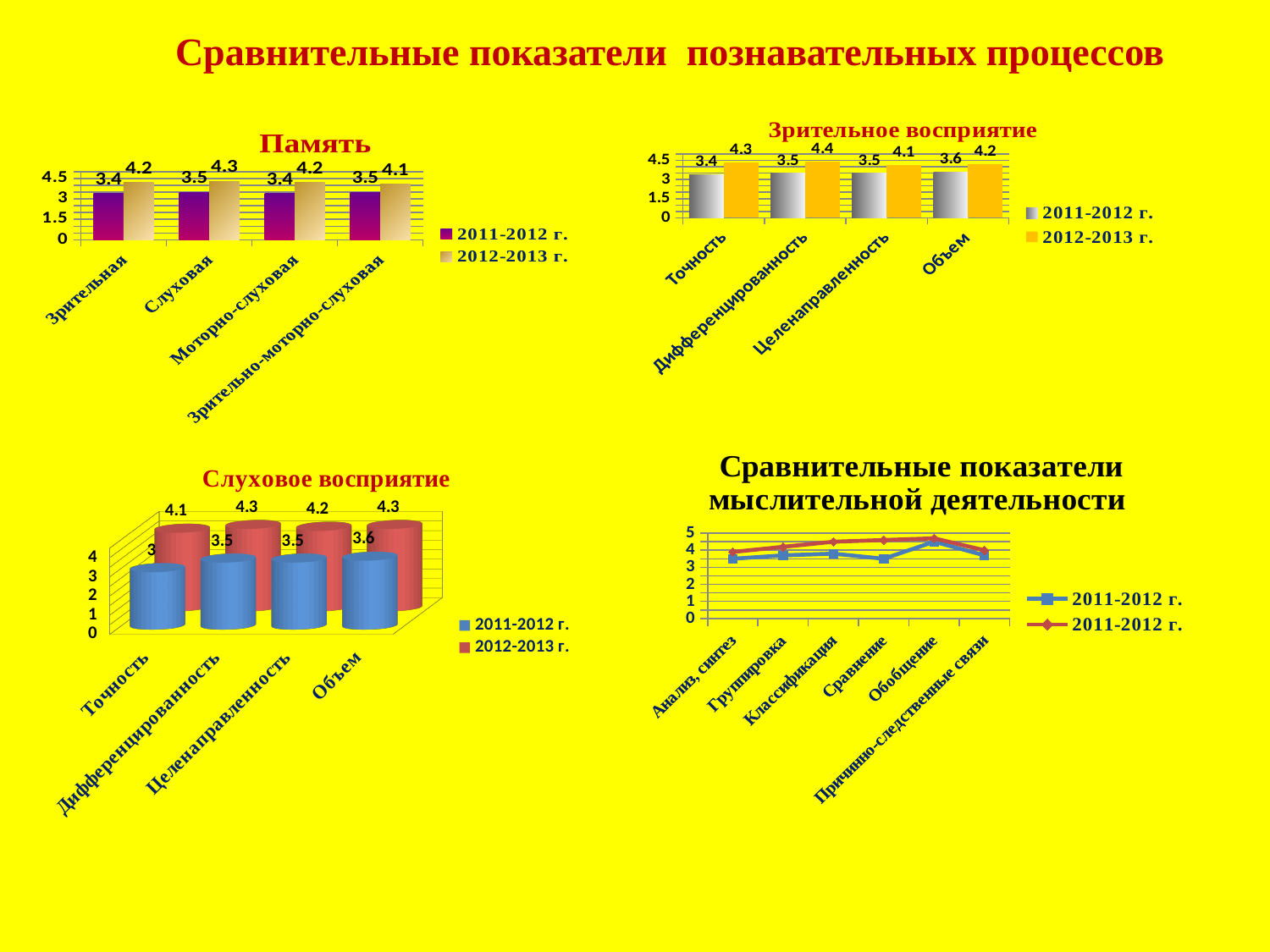
In the "Память" chart, what is the value for Слуховая in 2012-2013 г.? 4.3 In the "Слуховое восприятие" chart, what is the value for Точность in 2011-2012 г.? 3 What kind of chart is "Сравнительные показатели мыслительной деятельности"? line chart In the "Слуховое восприятие" chart, which is larger: the 2012-2013 г. value for Дифференцированность or for Целенаправленность? Дифференцированность In the "Зрительное восприятие" chart, what is the value for Дифференцированность in 2012-2013 г.? 4.4 In the "Слуховое восприятие" chart, what is the difference between the 2012-2013 г. and 2011-2012 г. values for Объем? 0.7 In the "Память" chart, what is the difference between the 2012-2013 г. and 2011-2012 г. values for Зрительная? 0.8 In the "Зрительное восприятие" chart, which category has the highest 2011-2012 г. value? Объем In the "Сравнительные показатели мыслительной деятельности" chart, is the value for Обобщение on the red line greater or less than 3? greater In the "Память" chart, which category has the lowest 2012-2013 г. value? Зрительно-моторно-слуховая In the "Зрительное восприятие" chart, how many categories are shown on the x axis? 4 In the "Сравнительные показатели мыслительной деятельности" chart, how many categories are shown on the x axis? 6